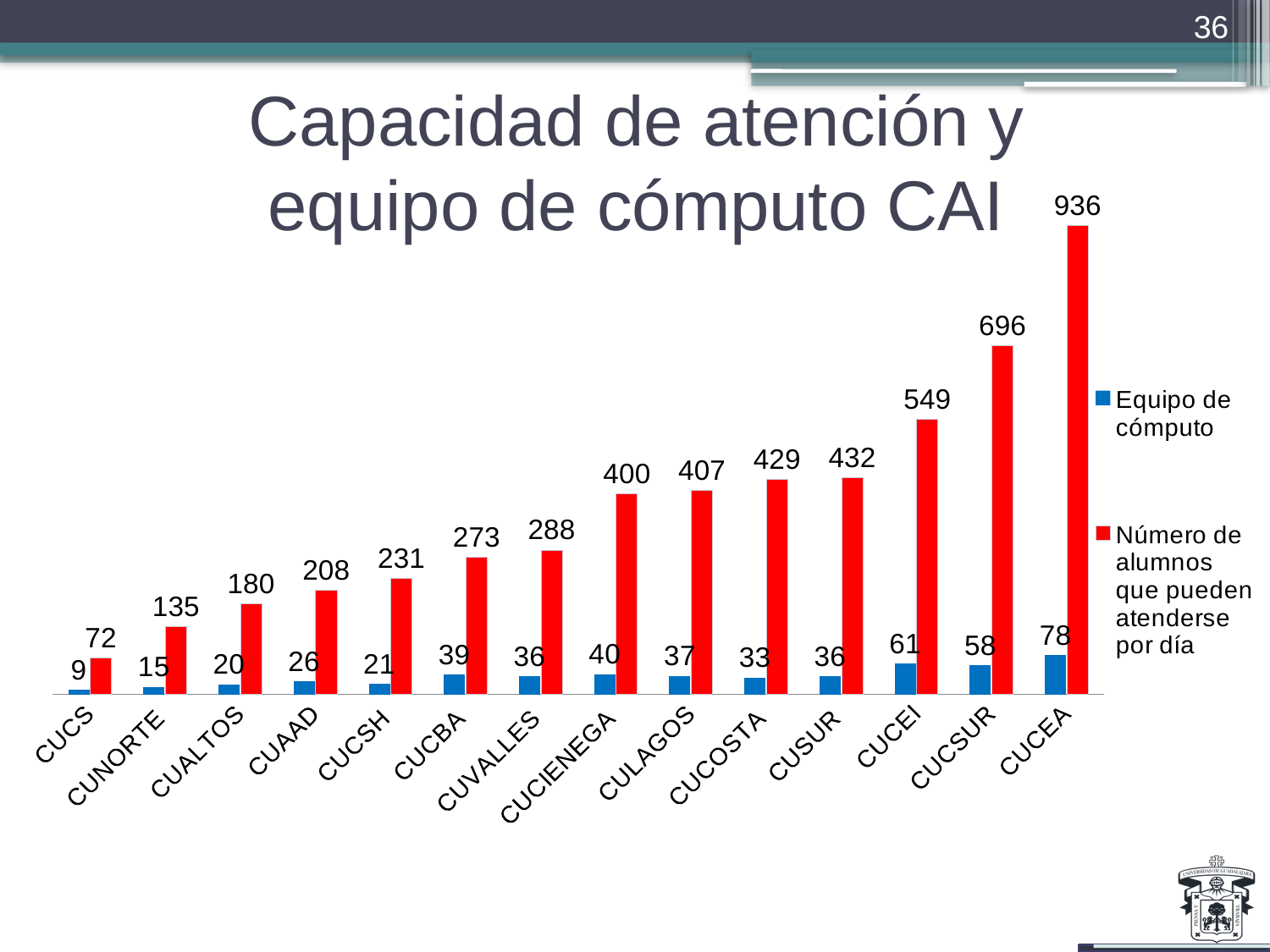
Do the 'Número de alumnos que pueden atenderse por día' values rise or fall from CUCS to CUCEA along the x axis? Rise Which has a larger 'Equipo de cómputo' value, CUCBA or CUCSH? CUCBA What is the value of 'Equipo de cómputo' for CUCEI? 61 How many categories are shown on the x axis? 14 What is the difference between the 'Número de alumnos que pueden atenderse por día' values for CUCEA and CUCSUR? 240 Which category has the lowest value for 'Equipo de cómputo'? CUCS What is the value of 'Número de alumnos que pueden atenderse por día' for CUCEA? 936 Which category has the highest value for 'Número de alumnos que pueden atenderse por día'? CUCEA What is the value of 'Número de alumnos que pueden atenderse por día' for CUCIENEGA? 400 How many series does the legend list? 2 What colour are the bars for 'Equipo de cómputo'? Blue What kind of chart is shown on the slide? Bar chart